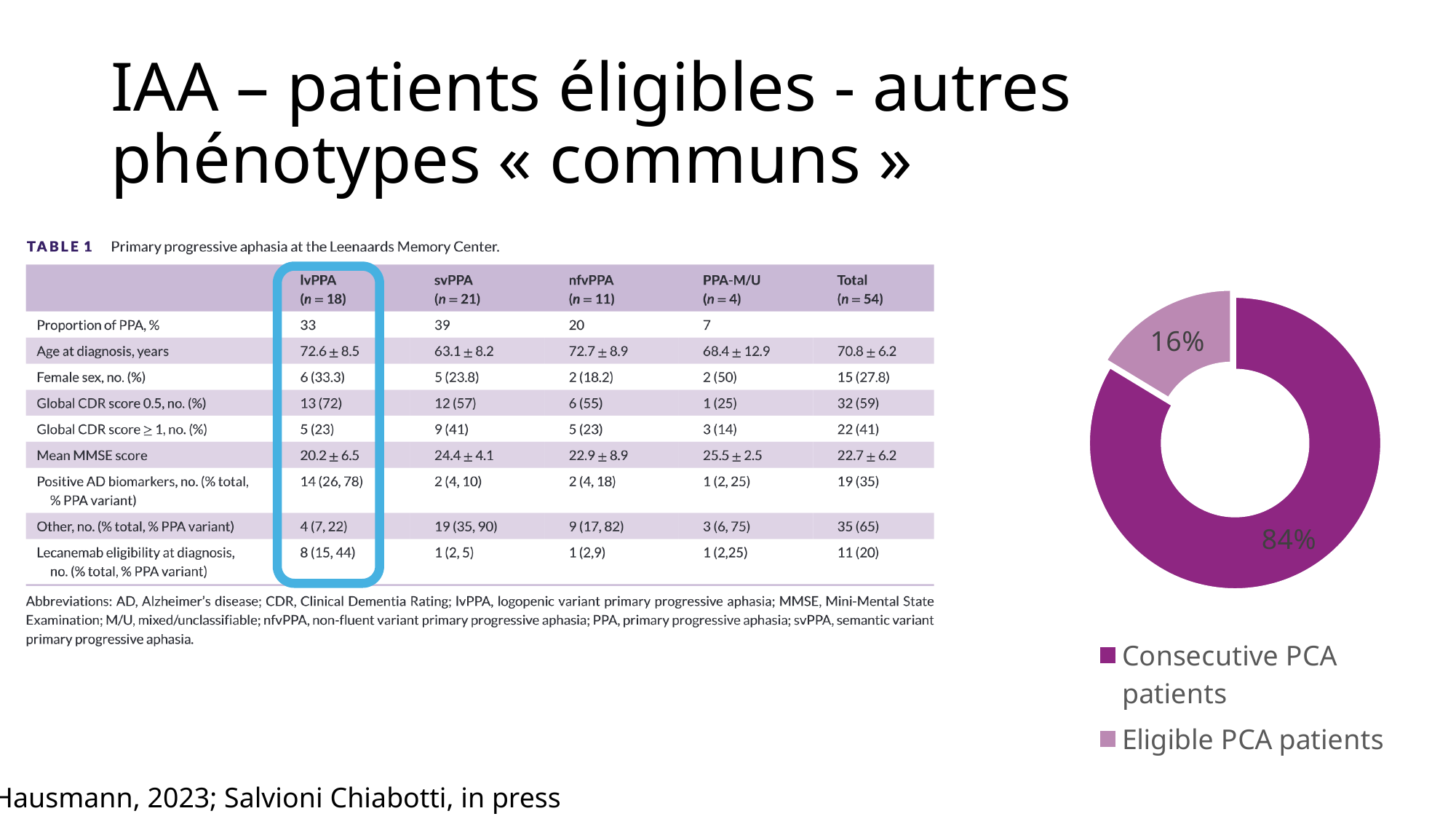
What kind of chart is shown on the right of the slide? Doughnut chart In the doughnut chart, what share is labelled for Consecutive PCA patients? 84% Which legend entry of the doughnut chart is shown in the lighter purple colour? Eligible PCA patients In the doughnut chart, what share is labelled for Eligible PCA patients? 16% Which slice of the doughnut chart is the largest? Consecutive PCA patients How many slices does the doughnut chart have? 2 In the doughnut chart, is the share for Eligible PCA patients greater or less than 20%? less What is the total of the two percentages shown on the doughnut chart? 100% What is the difference in percentage points between the two slices of the doughnut chart? 68 How many entries does the legend of the doughnut chart list? 2 Which slice of the doughnut chart is the smallest? Eligible PCA patients In the doughnut chart, which is larger: Consecutive PCA patients or Eligible PCA patients? Consecutive PCA patients